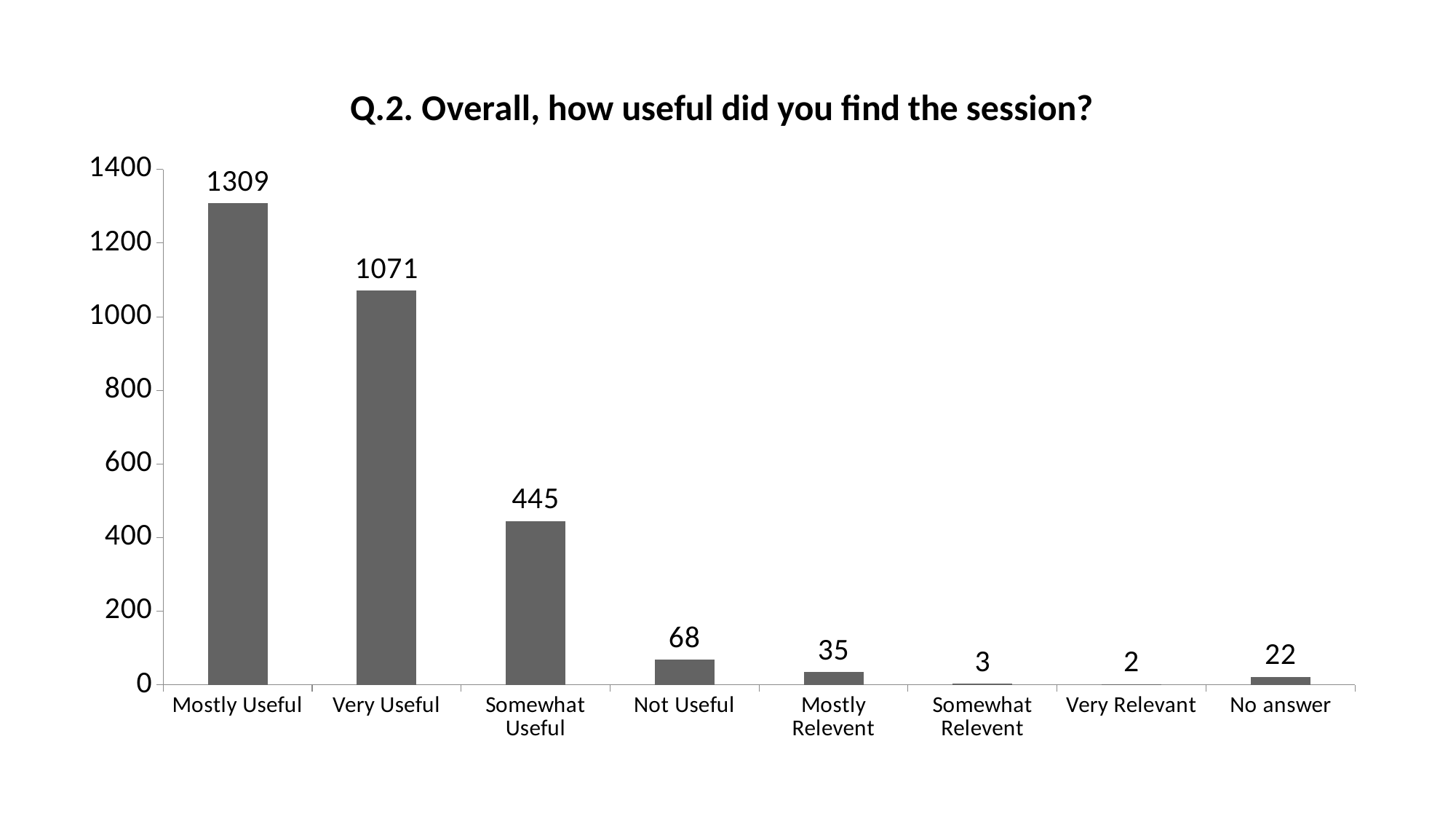
Is the value for Very Useful greater or less than 1000? greater What is the value for No answer? 22 Which category has the lowest value? Very Relevant What is the difference between the values for Mostly Useful and Very Useful? 238 What is the value for Mostly Useful? 1309 How many categories are shown on the x axis? 8 What is the value for Somewhat Useful? 445 Which category has the highest value? Mostly Useful What is the title of the chart? Q.2. Overall, how useful did you find the session? Which is larger, the value for Not Useful or the value for Mostly Relevent? Not Useful What is the difference between the values for Not Useful and Mostly Relevent? 33 What kind of chart is shown on the slide? bar chart